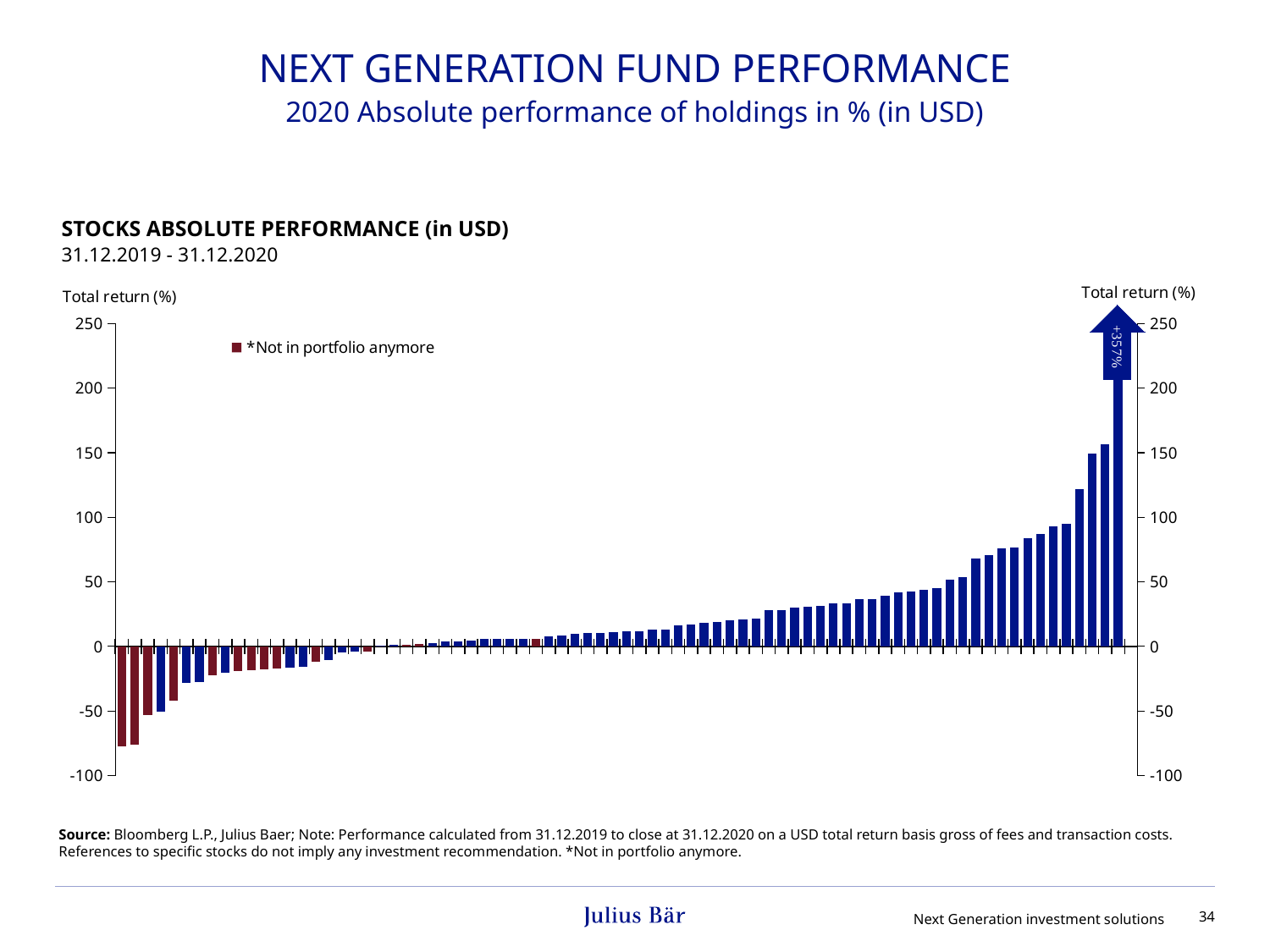
Is the value of the tallest bar greater or less than 250? greater What kind of chart is shown on the slide? bar chart Is the value of the leftmost bar greater or less than -50? less What value is printed on the tallest bar of the chart? +357% Do the bar values rise or fall from left to right along the x axis? rise What is the highest tick value shown on the y axis? 250 How many entries does the chart legend list? 1 What is the lowest tick value shown on the y axis? -100 Which bar is higher, the leftmost bar or the rightmost bar? the rightmost bar Is the value of the rightmost bar greater or less than 200? greater